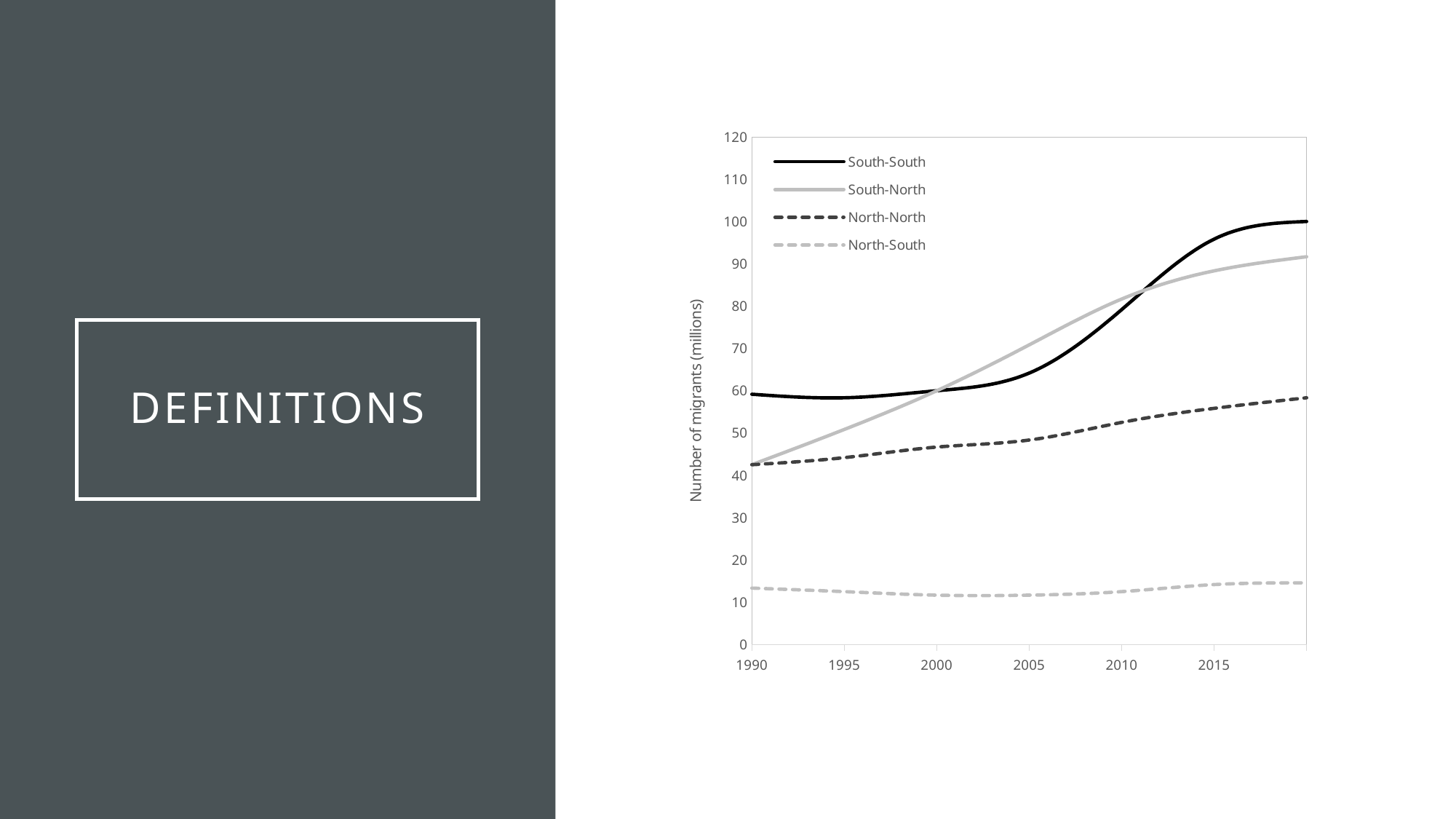
Which series has the highest value in 2015? South-South How many series does the legend list? 4 What kind of chart is shown on the slide? Line chart Is the value for North-North at the right end of the chart greater or less than 50? greater Is the value for South-North in 1990 greater or less than 50? less In 2015, which is larger: South-South or South-North? South-South Is the value for North-South in 1990 greater or less than 20? less What is the label on the vertical axis of the chart? Number of migrants (millions) In 2005, which is larger: South-South or South-North? South-North Which series has the lowest values across the whole period shown? North-South Does the North-North series rise or fall from 1990 to the end of the period? Rises Which series is drawn with a solid black line? South-South